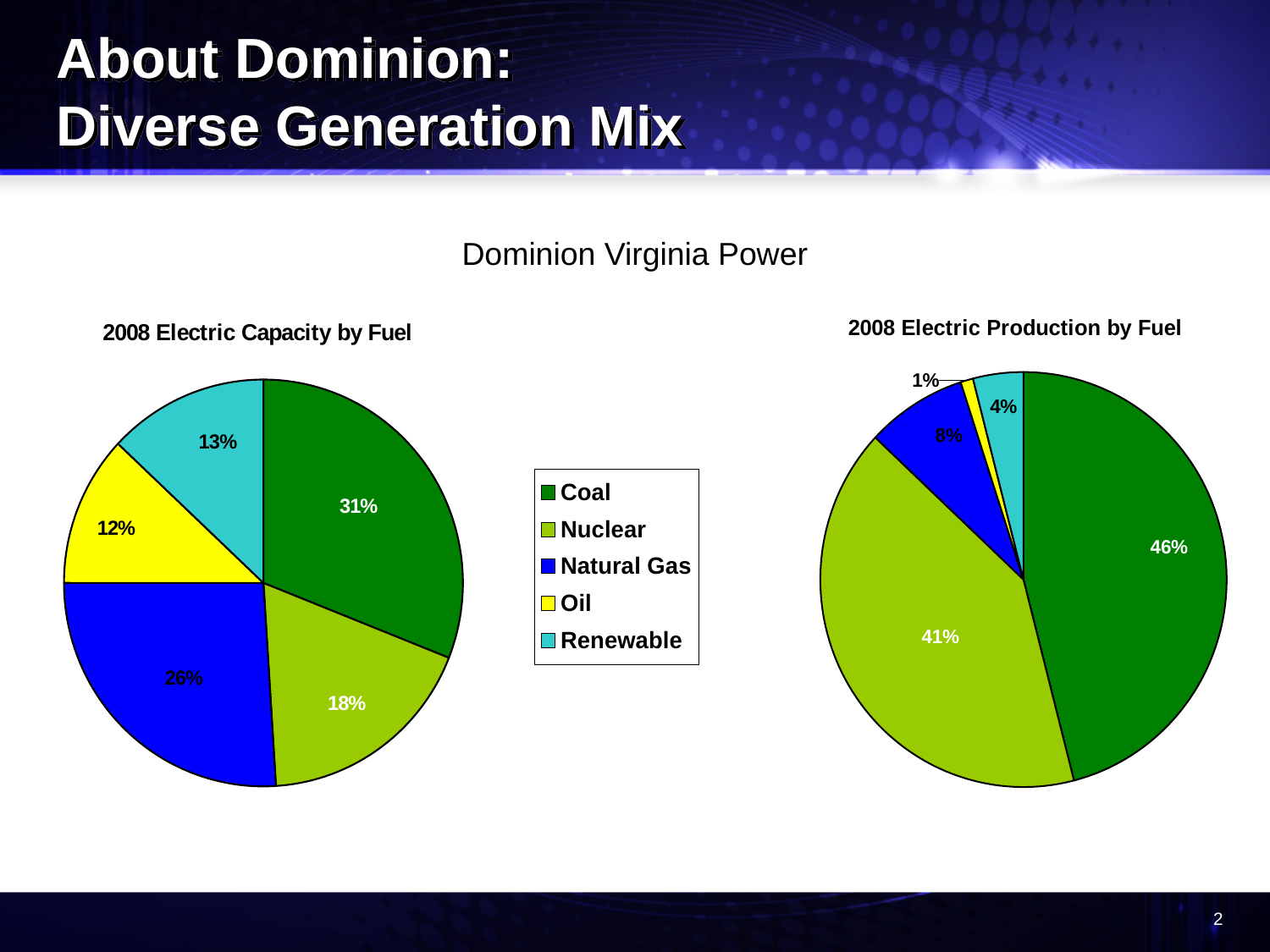
In the 2008 Electric Production by Fuel chart, what share of production is Oil? 1% In the 2008 Electric Production by Fuel chart, which fuel has the smallest share? Oil Which is larger: the Renewable share in the 2008 Electric Capacity by Fuel chart or the Renewable share in the 2008 Electric Production by Fuel chart? 2008 Electric Capacity by Fuel In the 2008 Electric Capacity by Fuel chart, which fuel has the largest share? Coal How many fuel categories does the legend list? 5 In the 2008 Electric Capacity by Fuel chart, what share of capacity is Natural Gas? 26% What colour represents Natural Gas in the legend? Blue What type of chart is the 2008 Electric Production by Fuel chart? Pie chart In the 2008 Electric Capacity by Fuel chart, what is the difference between the Natural Gas and Oil shares? 14% In the 2008 Electric Capacity by Fuel chart, what share of capacity is Coal? 31% In the 2008 Electric Production by Fuel chart, what is the difference between the Coal and Nuclear shares? 5% In the 2008 Electric Production by Fuel chart, what share of production is Nuclear? 41%